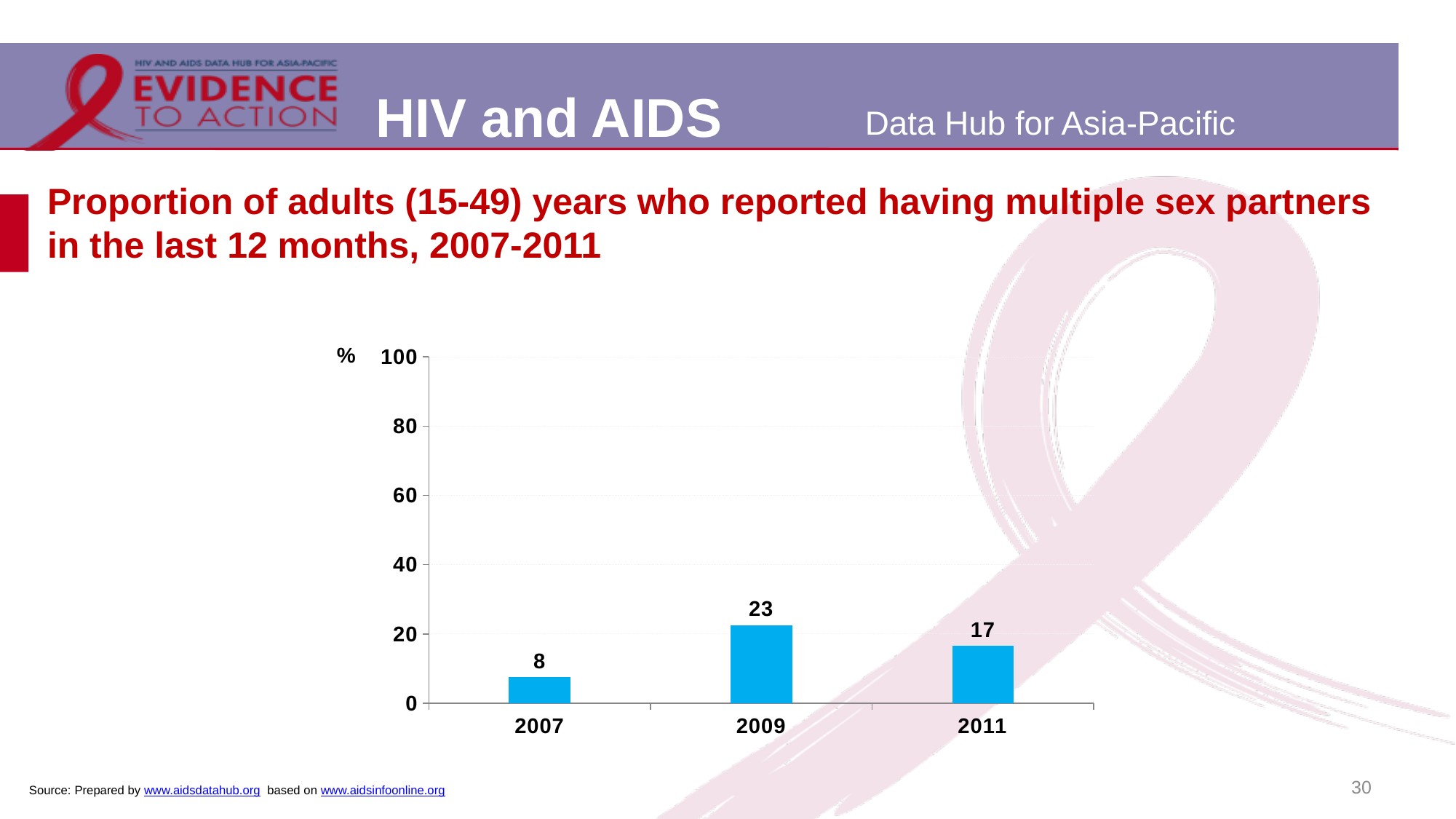
What unit is shown on the y axis of the chart? % How many years are shown on the x axis? 3 Which year has the highest value? 2009 Which is larger, the value for 2011 or the value for 2007? 2011 What is the value for 2007? 8 Is the value for 2009 greater or less than 20? greater What is the difference between the values for 2009 and 2011? 6 What is the value for 2011? 17 What kind of chart is shown on the slide? bar chart Which year has the lowest value? 2007 What is the value for 2009? 23 What is the difference between the values for 2009 and 2007? 15